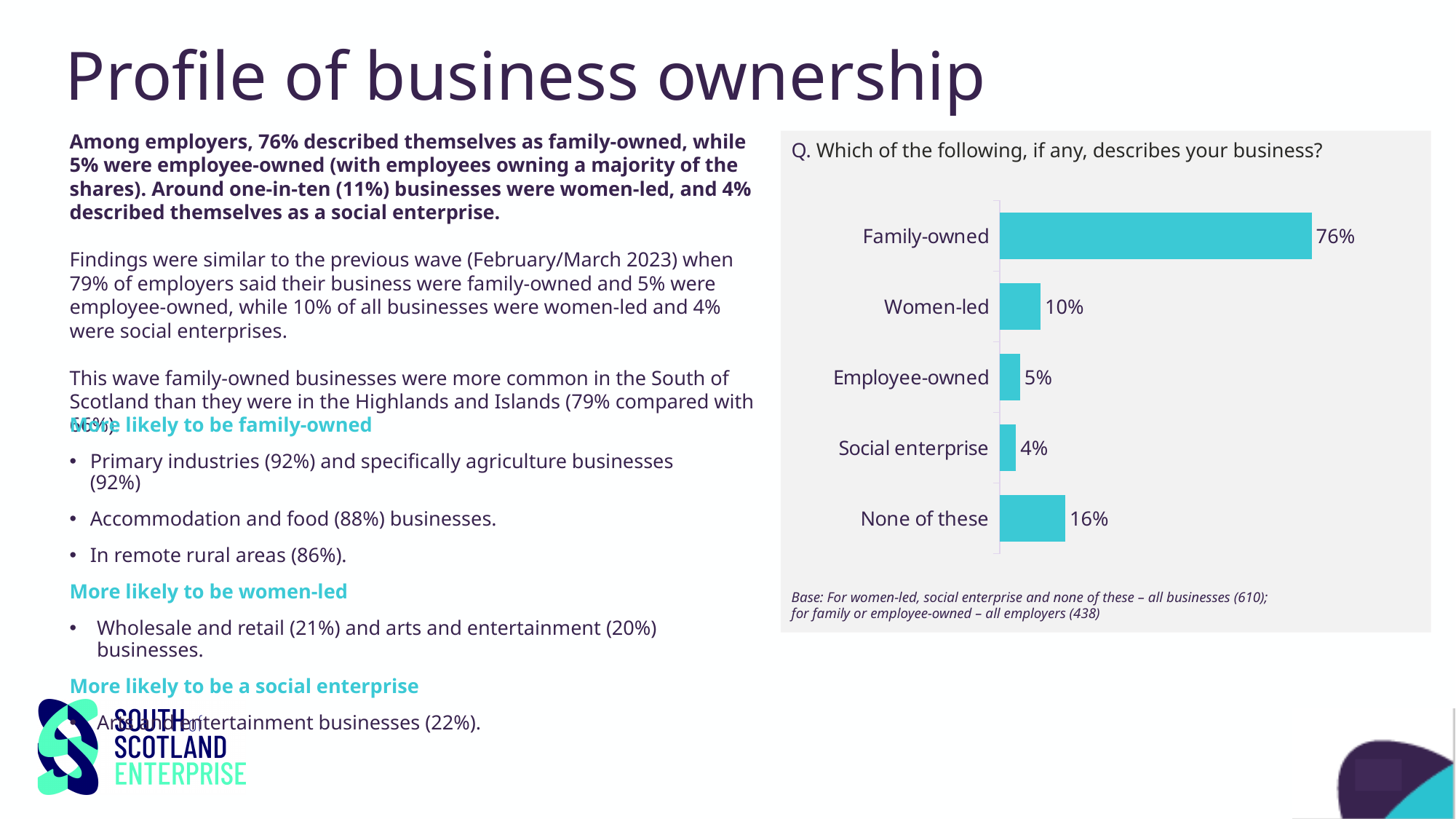
Which category has the lowest value in the chart? Social enterprise Which category has the highest value in the chart? Family-owned What question is the chart based on, as shown in its title? Q. Which of the following, if any, describes your business? What type of chart is shown on the slide? Bar chart What is the value for Social enterprise? 4% What is the value shown for Women-led? 10% What percentage is shown for Employee-owned? 5% What percentage of respondents described their business as family-owned? 76% What is the difference between the Family-owned and None of these values? 60% How many categories are shown in the chart? 5 Which is larger, the value for Women-led or the value for None of these? None of these What percentage selected None of these? 16%